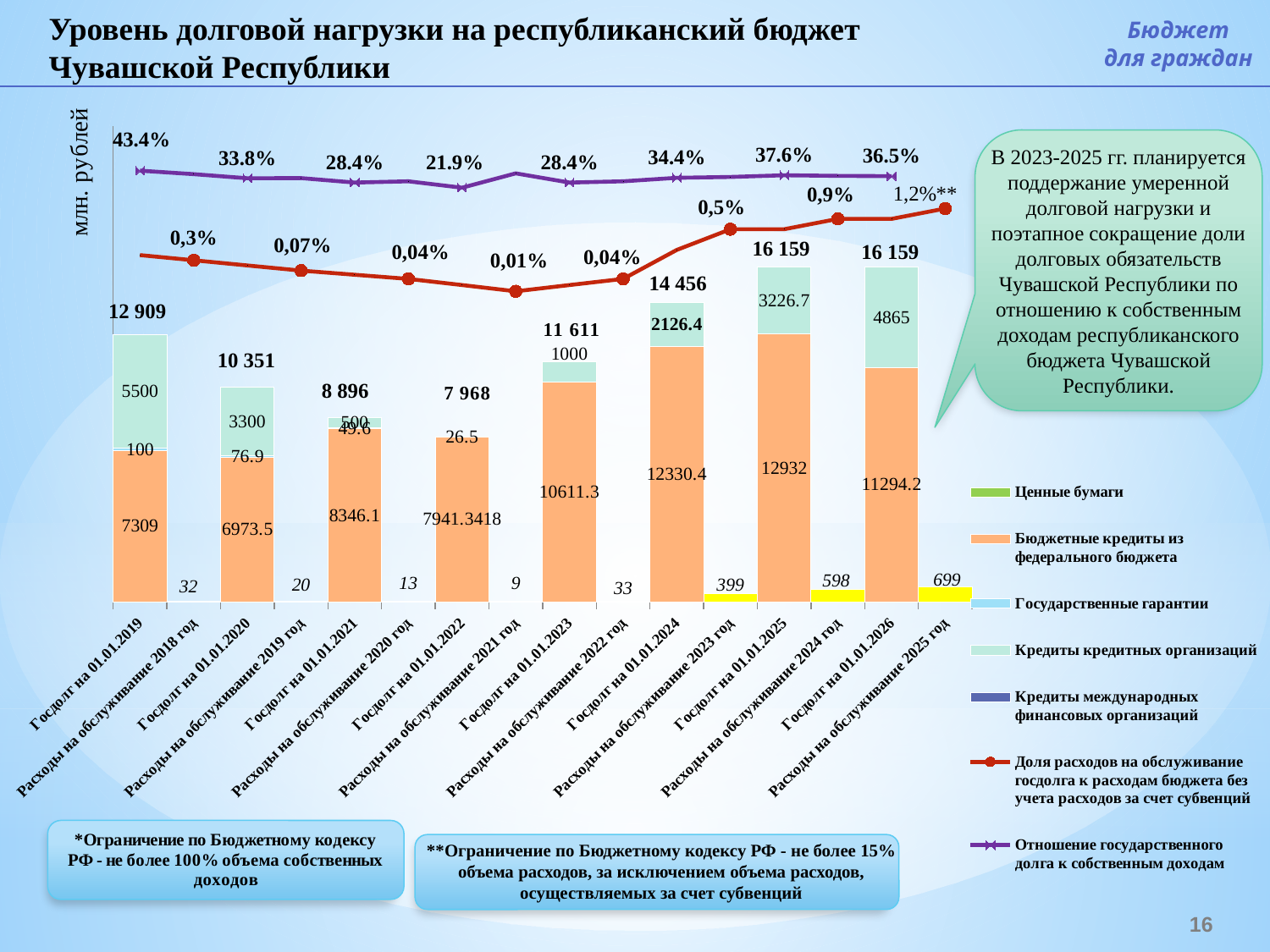
What is the value of 'Бюджетные кредиты из федерального бюджета' for 'Госдолг на 01.01.2023'? 10611.3 What is the total state debt shown above the bar for 'Госдолг на 01.01.2024'? 14 456 What is the lowest value shown on the line 'Отношение государственного долга к собственным доходам'? 21.9% How many categories are shown on the x axis of the chart? 16 How many series does the legend list? 7 What is the difference between the total debt for 'Госдолг на 01.01.2025' (16 159) and 'Госдолг на 01.01.2024' (14 456)? 1 703 What is the value for 'Расходы на обслуживание 2024 год'? 598 What kind of chart is shown on the slide? Stacked bar chart combined with line charts Which is larger: 'Кредиты кредитных организаций' for 'Госдолг на 01.01.2019' or for 'Госдолг на 01.01.2026'? Госдолг на 01.01.2019 (5500) What is the value of the line 'Доля расходов на обслуживание госдолга' for 'Расходы на обслуживание 2025 год'? 1,2% At which category does the line 'Отношение государственного долга к собственным доходам' reach its highest value? Госдолг на 01.01.2019 (43.4%) Does the line 'Отношение государственного долга к собственным доходам' rise or fall from 'Госдолг на 01.01.2022' to 'Госдолг на 01.01.2025'? Rises